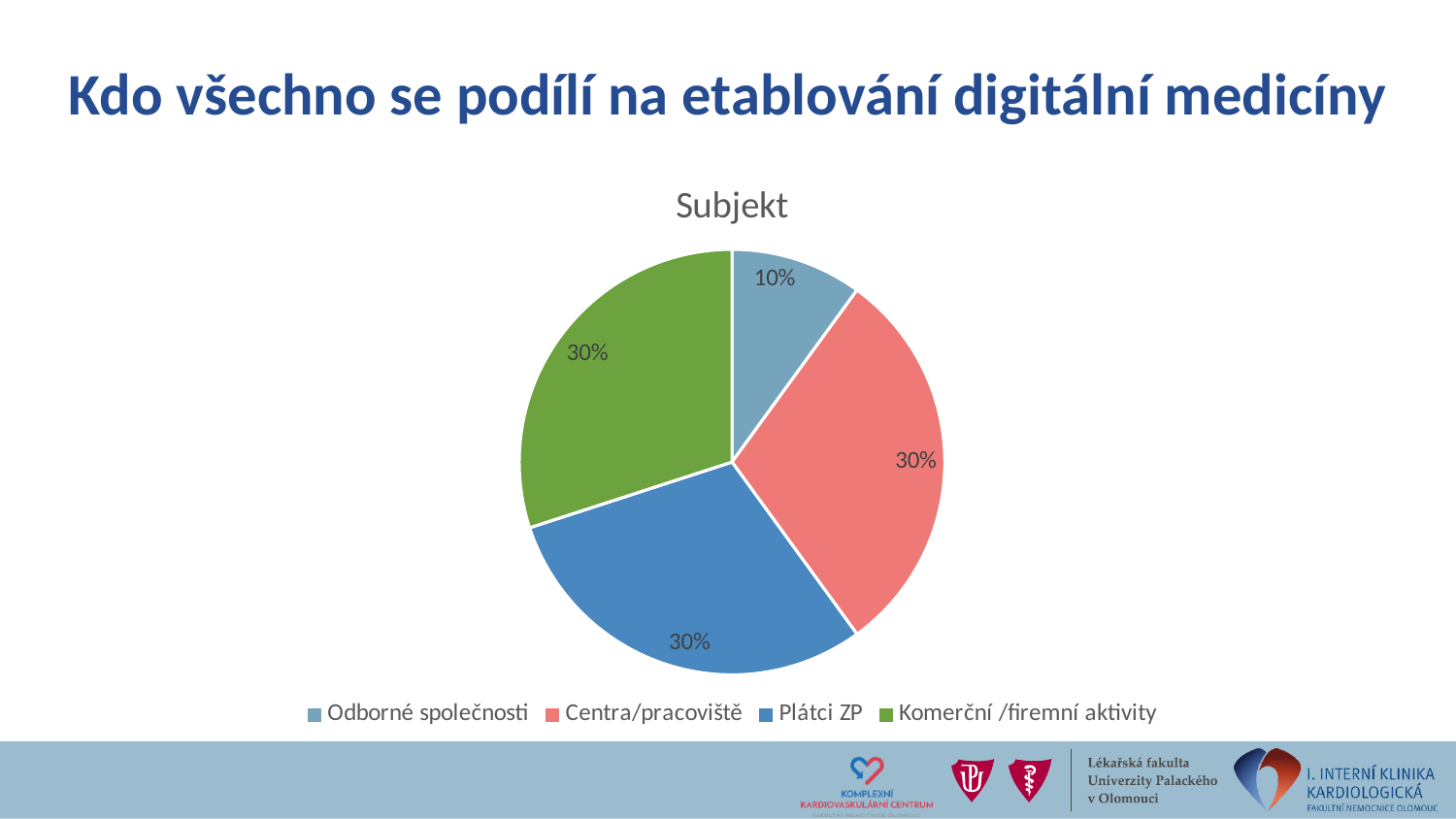
What is the title of the chart? Subjekt What is the value shown for Komerční /firemní aktivity? 30% How many slices does the pie chart have? 4 What is the value shown for Centra/pracoviště? 30% What share of the pie does Odborné společnosti represent? 10% Which category has the smallest slice of the pie? Odborné společnosti Which is larger, the slice for Odborné společnosti or the slice for Plátci ZP? Plátci ZP What kind of chart is shown on the slide? pie chart What is the value shown for Plátci ZP? 30% What is the difference in percentage points between Komerční /firemní aktivity and Odborné společnosti? 20 Which colour is used for the Komerční /firemní aktivity slice? green How many entries does the legend list? 4